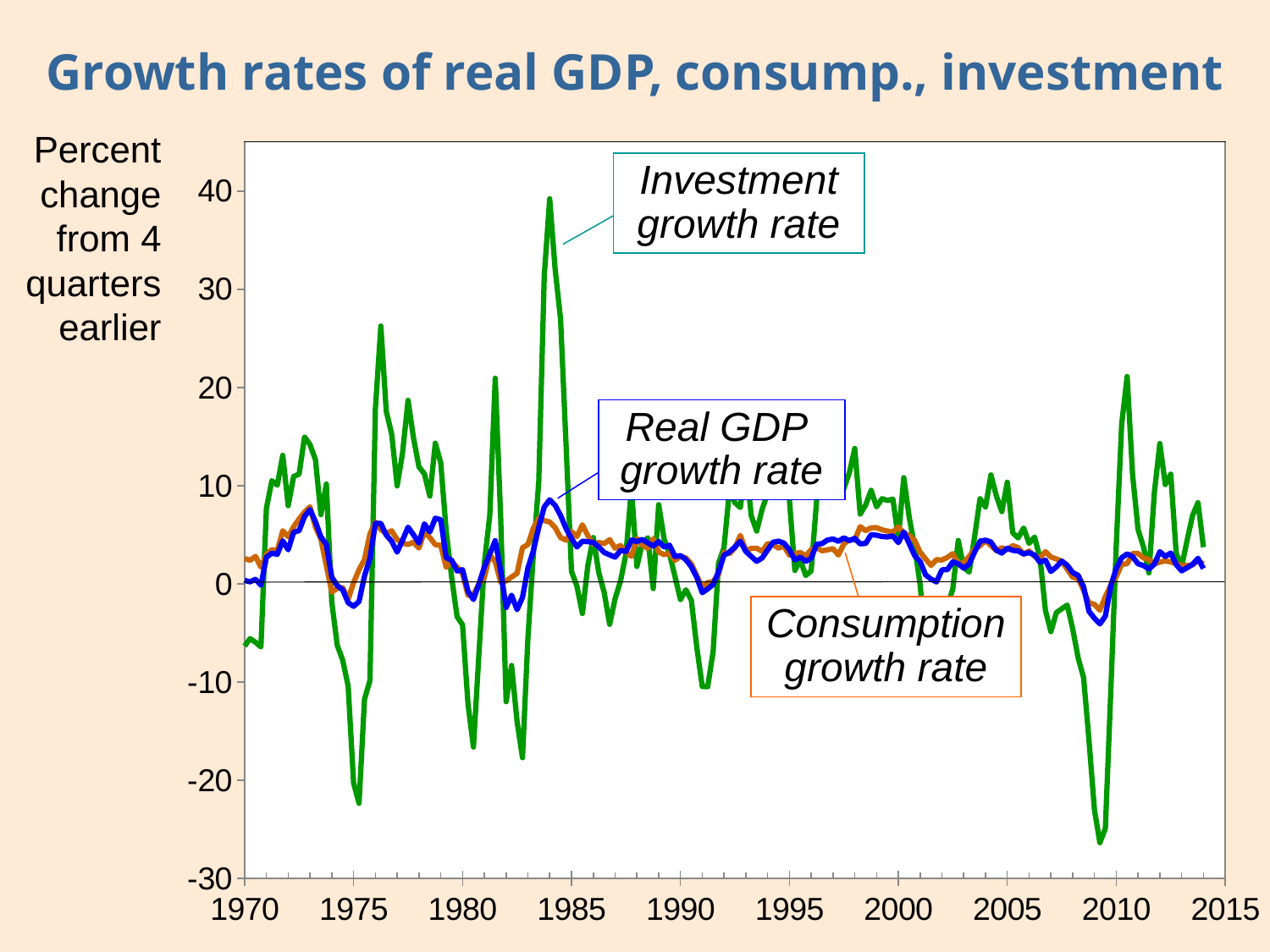
Which series reaches the lowest value on the chart? Investment growth rate What kind of chart is shown on the slide? line chart Is the peak value of the Real GDP growth rate around 1984 greater or less than 10? less What is the first year labeled on the x-axis? 1970 What does the y-axis measure, according to the label on the left of the chart? Percent change from 4 quarters earlier Is the peak value of the Investment growth rate around 1976 greater or less than 20? greater What is the title of the chart? Growth rates of real GDP, consump., investment Which series reaches the highest value on the chart? Investment growth rate Around 1984, which series has the larger value: Investment growth rate or Real GDP growth rate? Investment growth rate Is the peak value of the Investment growth rate around 1984 greater or less than 30? greater How many series are plotted on the chart? 3